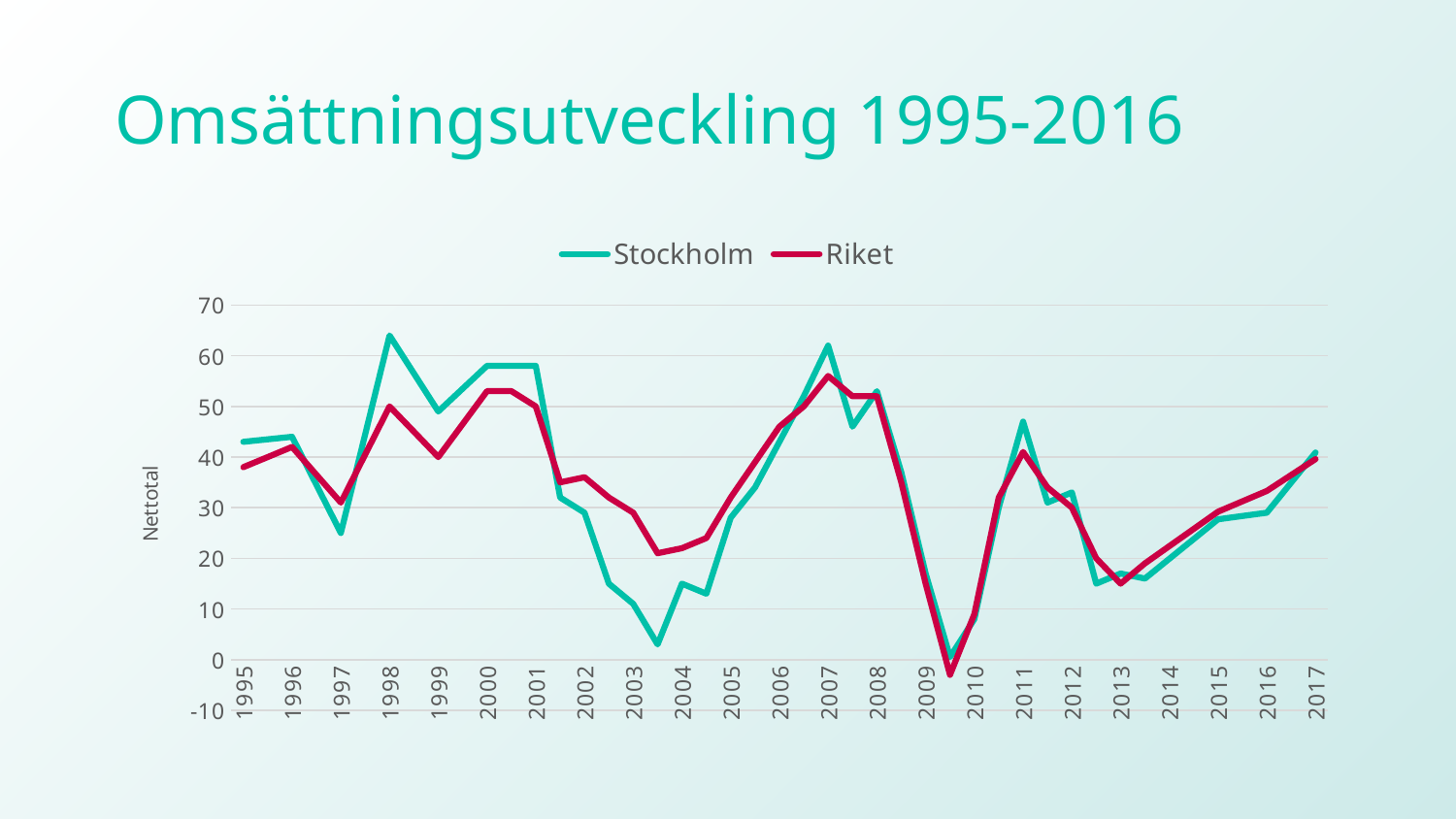
In 1998, which series has the higher value, Stockholm or Riket? Stockholm How many year labels are shown on the x axis? 23 In 2003, which series has the higher value, Stockholm or Riket? Riket What are the two series named in the legend? Stockholm and Riket What is the label on the vertical axis? Nettotal Is the value for Riket in 2007 greater or less than 50? greater Is the value for Stockholm in 2013 greater or less than 20? less How many series does the legend list? 2 Is the value for Stockholm in 2003 greater or less than 20? less Do the values for Stockholm rise or fall between 2007 and 2009? Fall What kind of chart is shown on the slide? Line chart